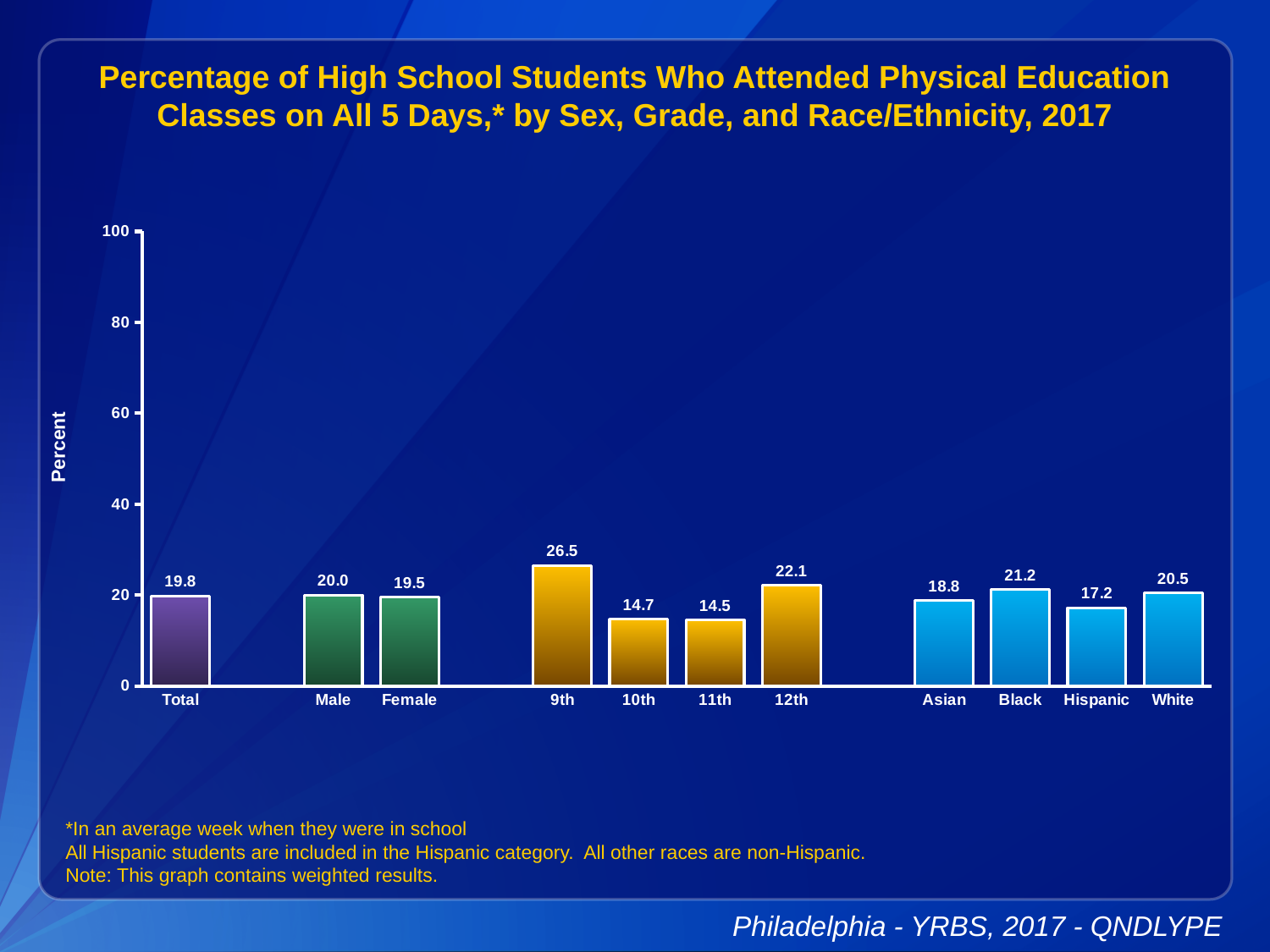
What is the value for Total? 19.8 Which category has the lowest value? 11th What kind of chart is this? bar chart Which is larger, the value for Black or the value for Asian? Black What is the label of the y axis? Percent What is the value for 9th grade? 26.5 Which category has the highest value? 9th How many categories are shown on the x axis? 11 Is the value for 12th grade greater or less than 20? greater What is the value for Hispanic students? 17.2 What is the difference between the values for 9th and 10th grade? 11.8 What is the difference between the values for Male and Female? 0.5